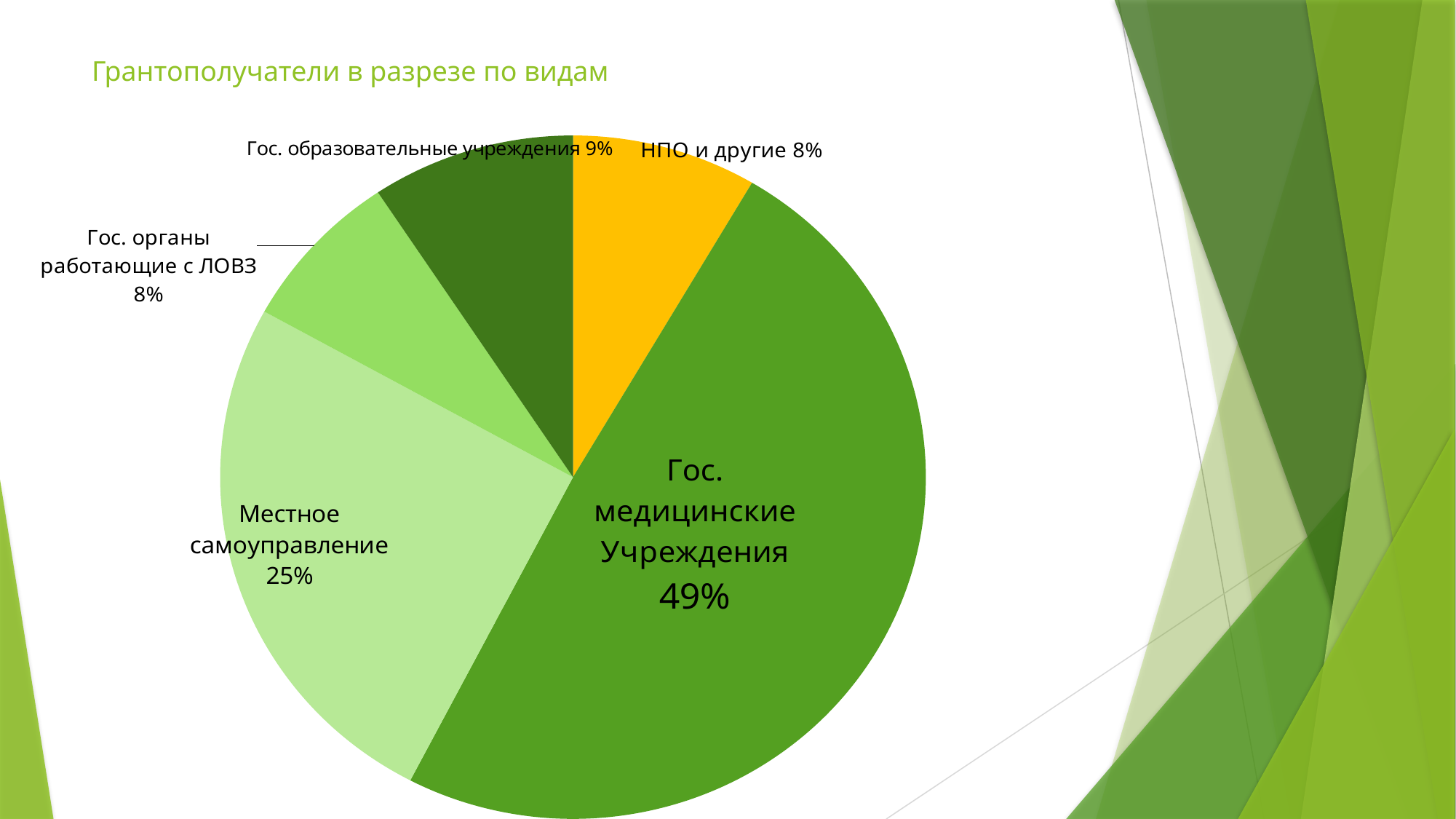
What share of the pie is Гос. органы работающие с ЛОВЗ? 8% Which category has the largest slice of the pie? Гос. медицинские Учреждения What is the title of the chart? Грантополучатели в разрезе по видам What share of the pie is Гос. медицинские Учреждения? 49% What colour is the slice for НПО и другие? Yellow What share of the pie is НПО и другие? 8% How many slices does the pie chart have? 5 What kind of chart is shown on the slide? Pie chart Which is larger, the share for Гос. образовательные учреждения or the share for НПО и другие? Гос. образовательные учреждения What is the difference in percentage points between Гос. медицинские Учреждения and Местное самоуправление? 24